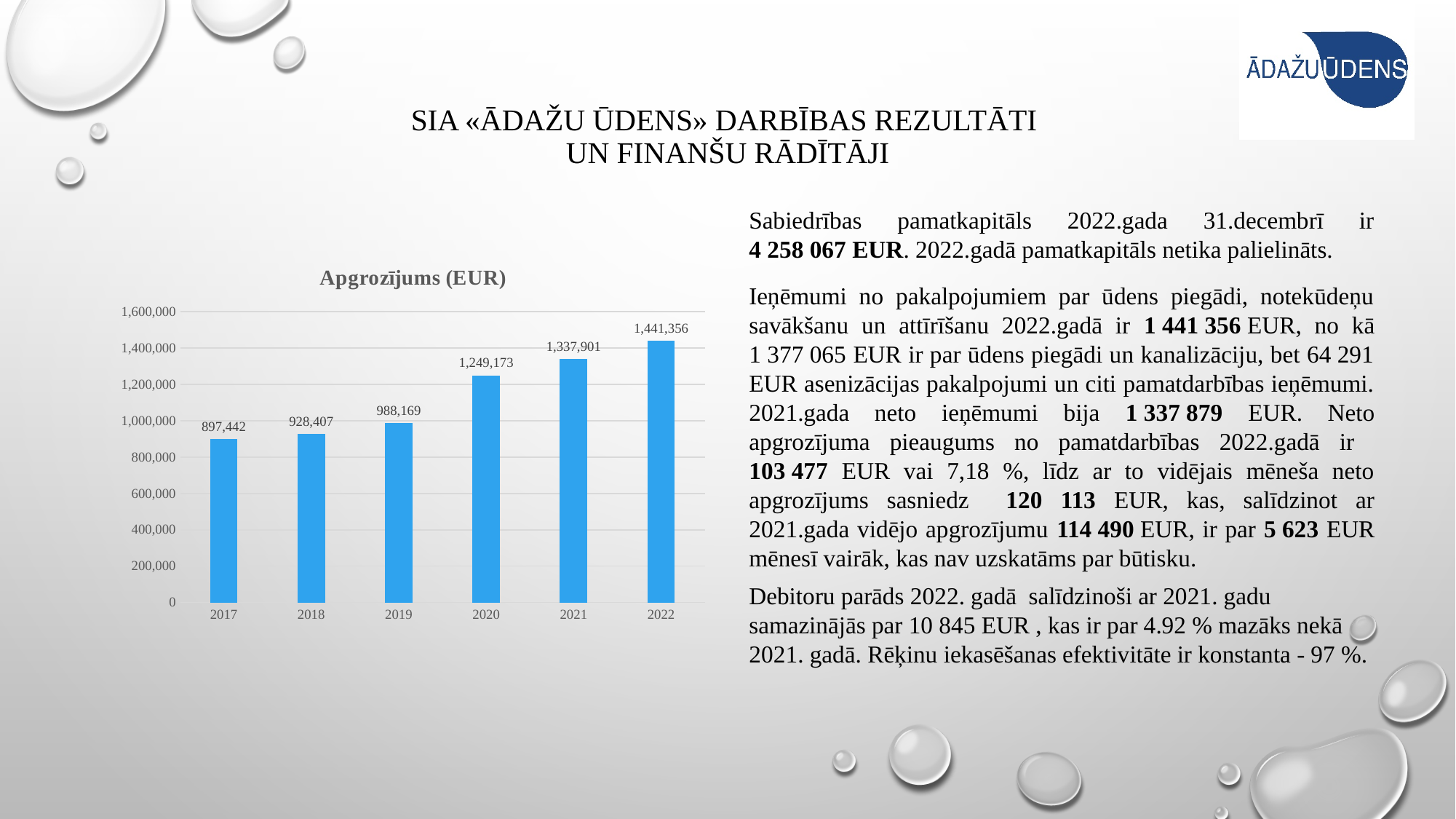
What kind of chart is the Apgrozījums (EUR) chart? bar chart Do the values in the Apgrozījums (EUR) chart rise or fall from 2017 to 2022? rise Is the value for 2019 in the Apgrozījums (EUR) chart greater or less than 1,000,000? less Which year has the highest value in the Apgrozījums (EUR) chart? 2022 What is the value for 2020 in the Apgrozījums (EUR) chart? 1,249,173 Which year has the lowest value in the Apgrozījums (EUR) chart? 2017 What is the difference between the 2018 and 2017 values in the Apgrozījums (EUR) chart? 30,965 What is the value for 2017 in the Apgrozījums (EUR) chart? 897,442 Which is larger in the Apgrozījums (EUR) chart, the value for 2019 or the value for 2020? 2020 What is the difference between the 2022 and 2021 values in the Apgrozījums (EUR) chart? 103,455 How many years are shown in the Apgrozījums (EUR) chart? 6 What is the value for 2022 in the Apgrozījums (EUR) chart? 1,441,356